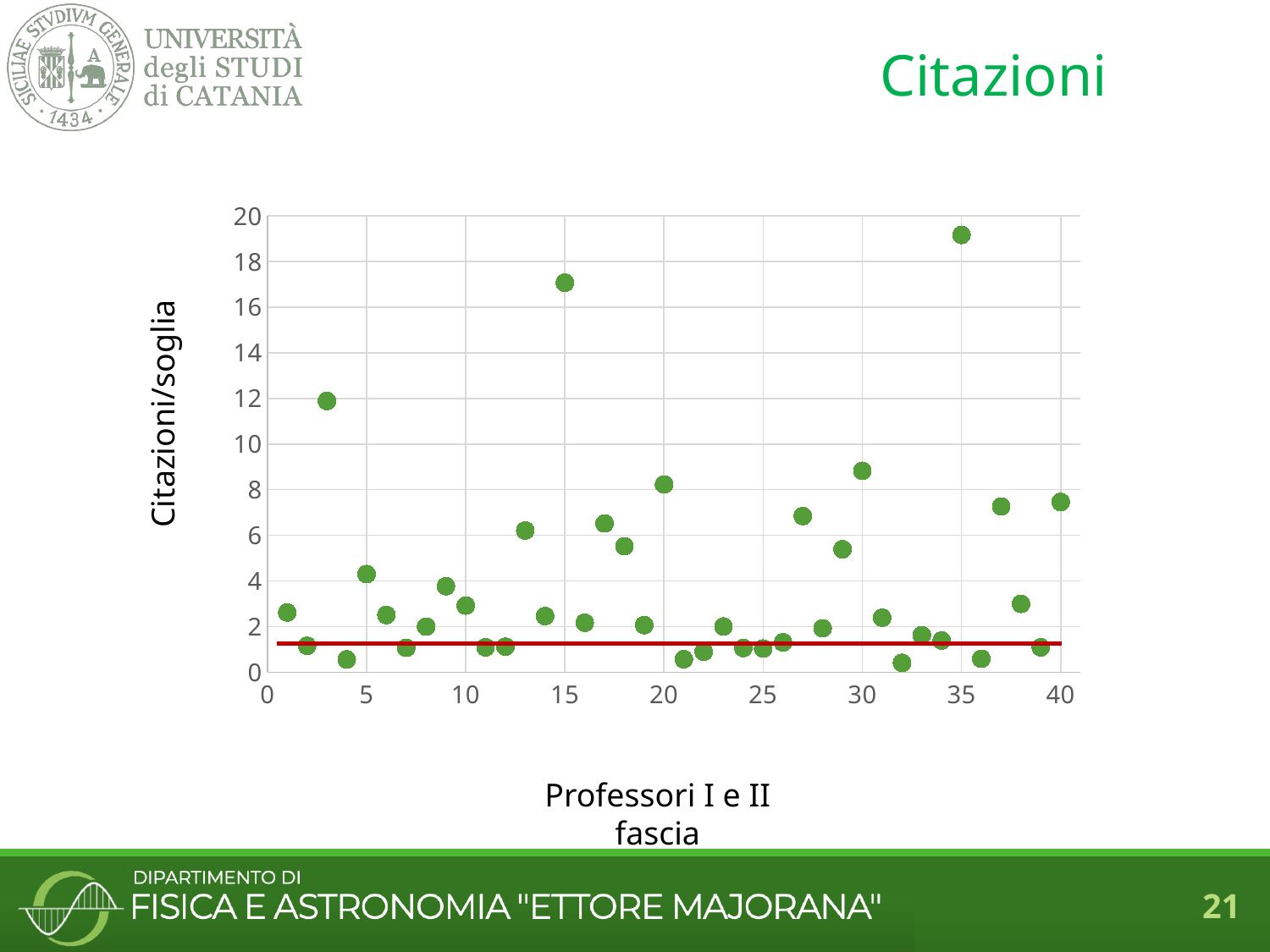
Which point has the larger value, the one at x = 3 or the one at x = 20? x = 3 Is the value of the point at x = 15 greater or less than 16? greater Is the value of the point at x = 35 greater or less than 18? greater What is the title of the chart on the slide? Citazioni At which x-axis position is the highest point on the chart? 35 Is the value of the point at x = 3 greater or less than 10? greater What is the label of the vertical axis of the chart? Citazioni/soglia What kind of chart is shown on the slide? scatter chart Which point has the larger value, the one at x = 15 or the one at x = 35? x = 35 How many data points are plotted on the chart? 40